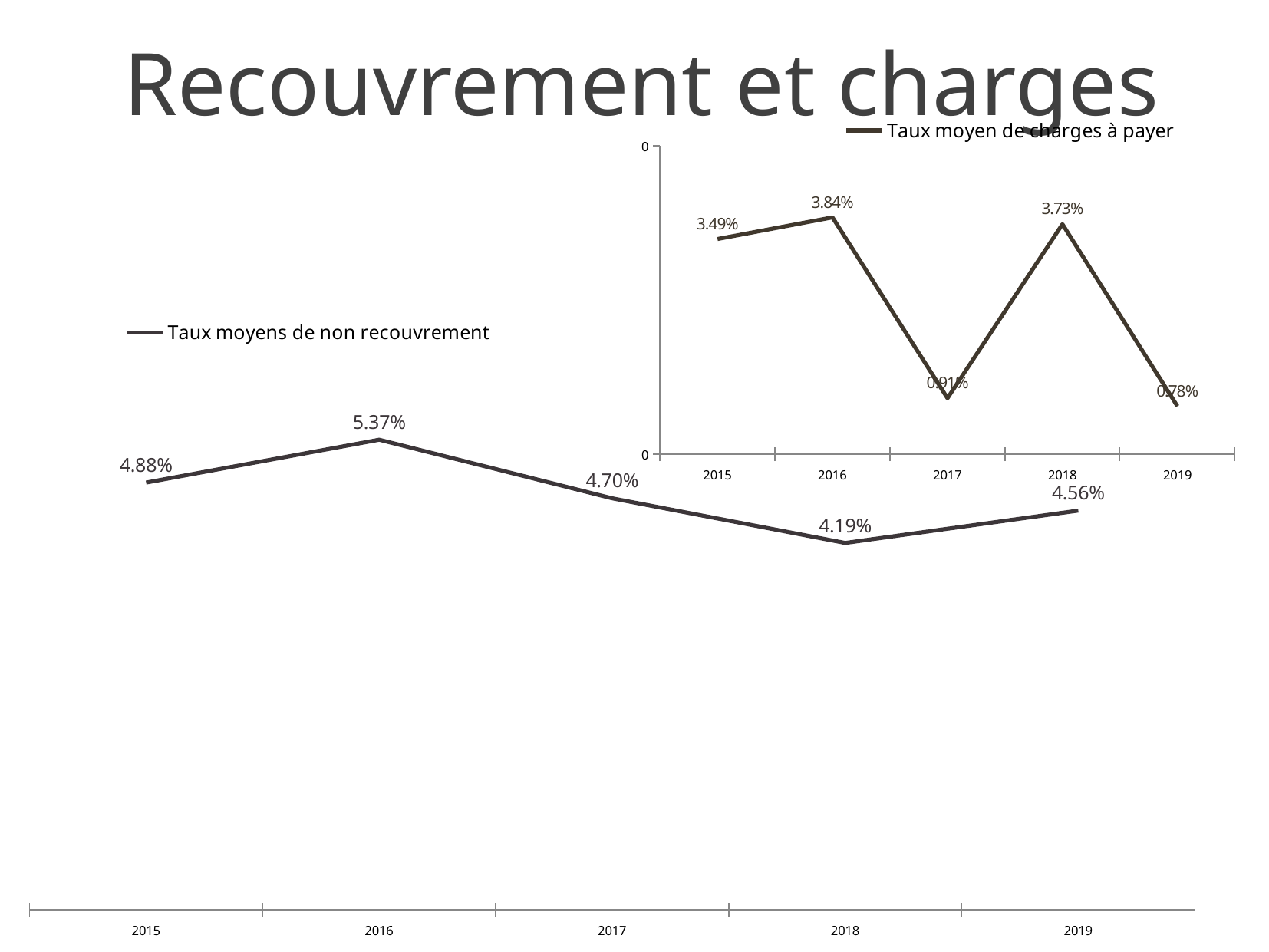
In the 'Taux moyens de non recouvrement' chart, what is the value for 2016? 5.37% In the 'Taux moyens de non recouvrement' chart, which year has the highest value? 2016 In the 'Taux moyen de charges à payer' chart, what is the value for 2015? 3.49% In the 'Taux moyen de charges à payer' chart, which is larger, the value for 2016 or the value for 2017? 2016 In the 'Taux moyens de non recouvrement' chart, which year has the lowest value? 2018 In the 'Taux moyens de non recouvrement' chart, how many years are plotted? 5 In the 'Taux moyen de charges à payer' chart, what is the difference between the 2016 and 2015 values? 0.35% What kind of chart is the 'Taux moyen de charges à payer' chart? Line chart What is the title of the slide? Recouvrement et charges In the 'Taux moyens de non recouvrement' chart, what is the difference between the 2016 and 2015 values? 0.49% In the 'Taux moyen de charges à payer' chart, what is the value for 2018? 3.73% In the 'Taux moyens de non recouvrement' chart, what is the value for 2018? 4.19%